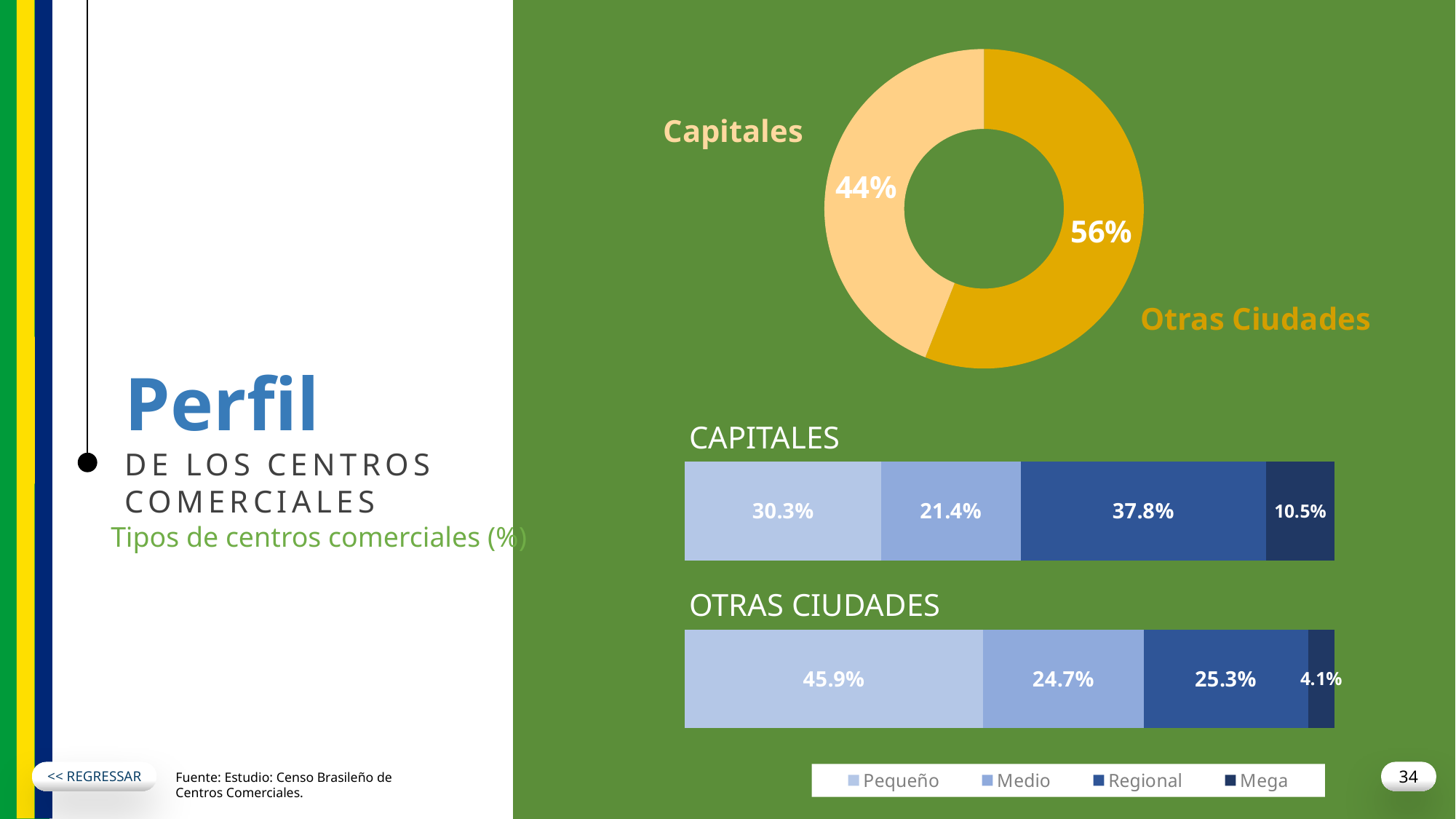
In the stacked bar chart, which is larger, the Medio value for CAPITALES or the Medio value for OTRAS CIUDADES? OTRAS CIUDADES How many series does the legend of the stacked bar chart list? 4 What kind of chart is the chart at the top of the slide? Donut (pie) chart In the stacked bar chart, what is the Mega value for OTRAS CIUDADES? 4.1% In the stacked bar chart, what is the difference between the Mega values for CAPITALES and OTRAS CIUDADES? 6.4% In the donut chart at the top, which segment is larger, Capitales or Otras Ciudades? Otras Ciudades In the stacked bar chart, what is the Regional value for CAPITALES? 37.8% In the donut chart at the top, what share is labelled for Otras Ciudades? 56% In the stacked bar chart, which category has the lowest value in the OTRAS CIUDADES bar? Mega In the donut chart at the top, what share is labelled for Capitales? 44% In the stacked bar chart, which category has the highest value in the CAPITALES bar? Regional In the stacked bar chart, what is the Pequeño value for OTRAS CIUDADES? 45.9%